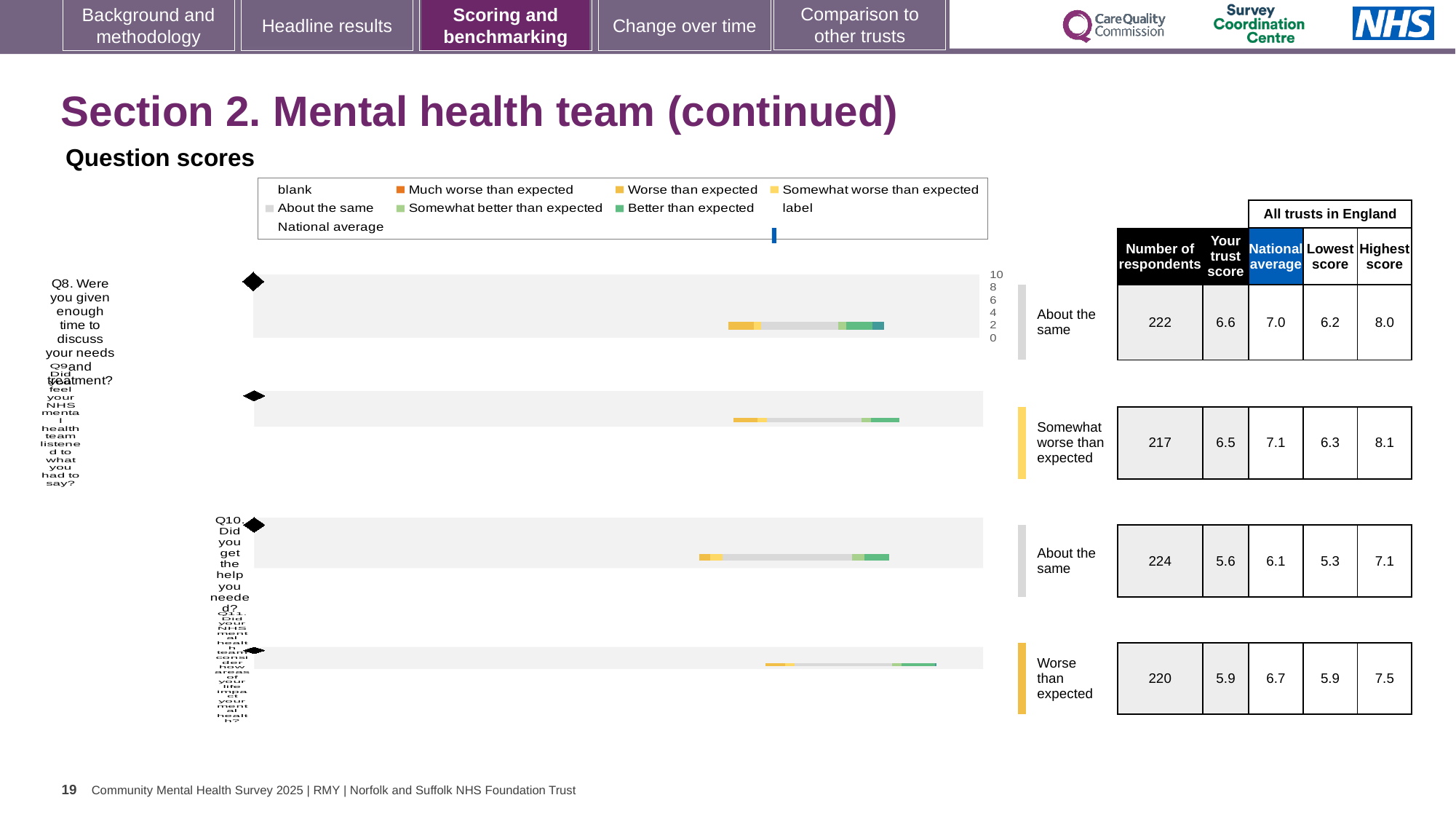
How many questions are plotted on this slide? 4 What is the lowest score among all trusts in England for Q10 (Did you get the help you needed?)? 5.3 What is the national average for Q9 (Did you feel your NHS mental health team listened to what you had to say?)? 7.1 What is the highest score among all trusts in England for Q11 (Did your NHS mental health team consider how areas of your life impact your mental health?)? 7.5 Which question has the highest trust score on this slide? Q8 For Q11, how much higher is the national average than the trust score? 0.8 What kind of chart is used to show the question scores? Bar chart What benchmark category is shown for Q11 (Did your NHS mental health team consider how areas of your life impact your mental health?)? Worse than expected How many respondents answered Q8 (Were you given enough time to discuss your needs and treatment?)? 222 Which question has the lowest trust score on this slide? Q10 Which is larger, the trust score for Q9 or the trust score for Q10? Q9 What is the trust score for Q8 (Were you given enough time to discuss your needs and treatment?)? 6.6